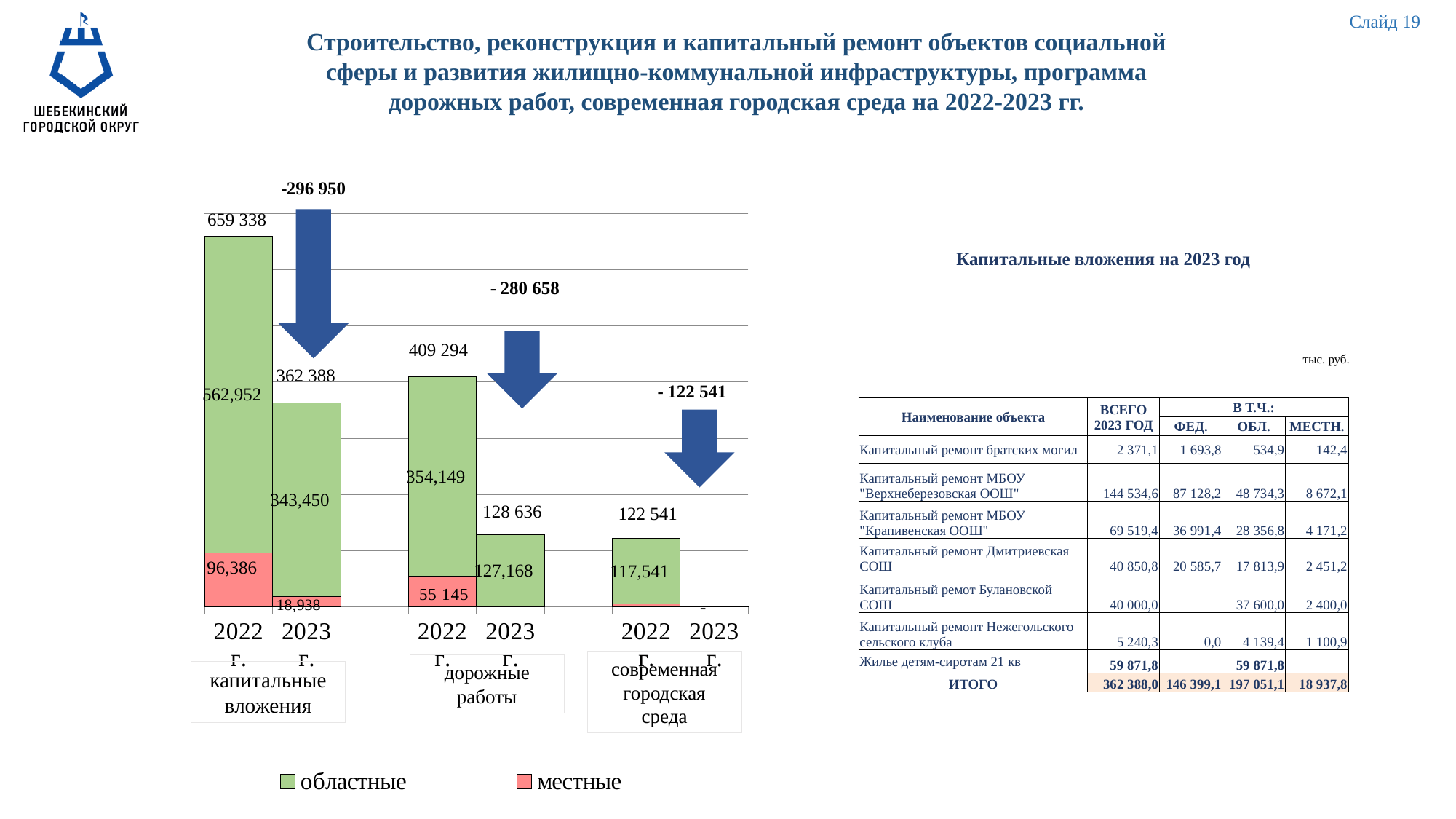
What are the two series named in the chart legend? областные, местные Which is larger: the областные segment for дорожные работы in 2022 or for дорожные работы in 2023? дорожные работы 2022 What is the value of the местные segment for капитальные вложения in 2023? 18,938 What is the value of the областные segment for капитальные вложения in 2022? 562,952 What is the value of the местные segment for дорожные работы in 2022? 55 145 Which stacked bar has the highest total in the chart? капитальные вложения 2022 How many series does the chart legend list? 2 What is the total of the stacked bar for дорожные работы in 2022? 409 294 What is the value of the областные segment for современная городская среда in 2022? 117,541 What is the difference between the totals for капитальные вложения in 2022 and 2023, as shown by the arrow label? -296 950 What kind of chart is shown on the left of the slide? bar chart Do the totals for each category rise or fall from 2022 to 2023? fall